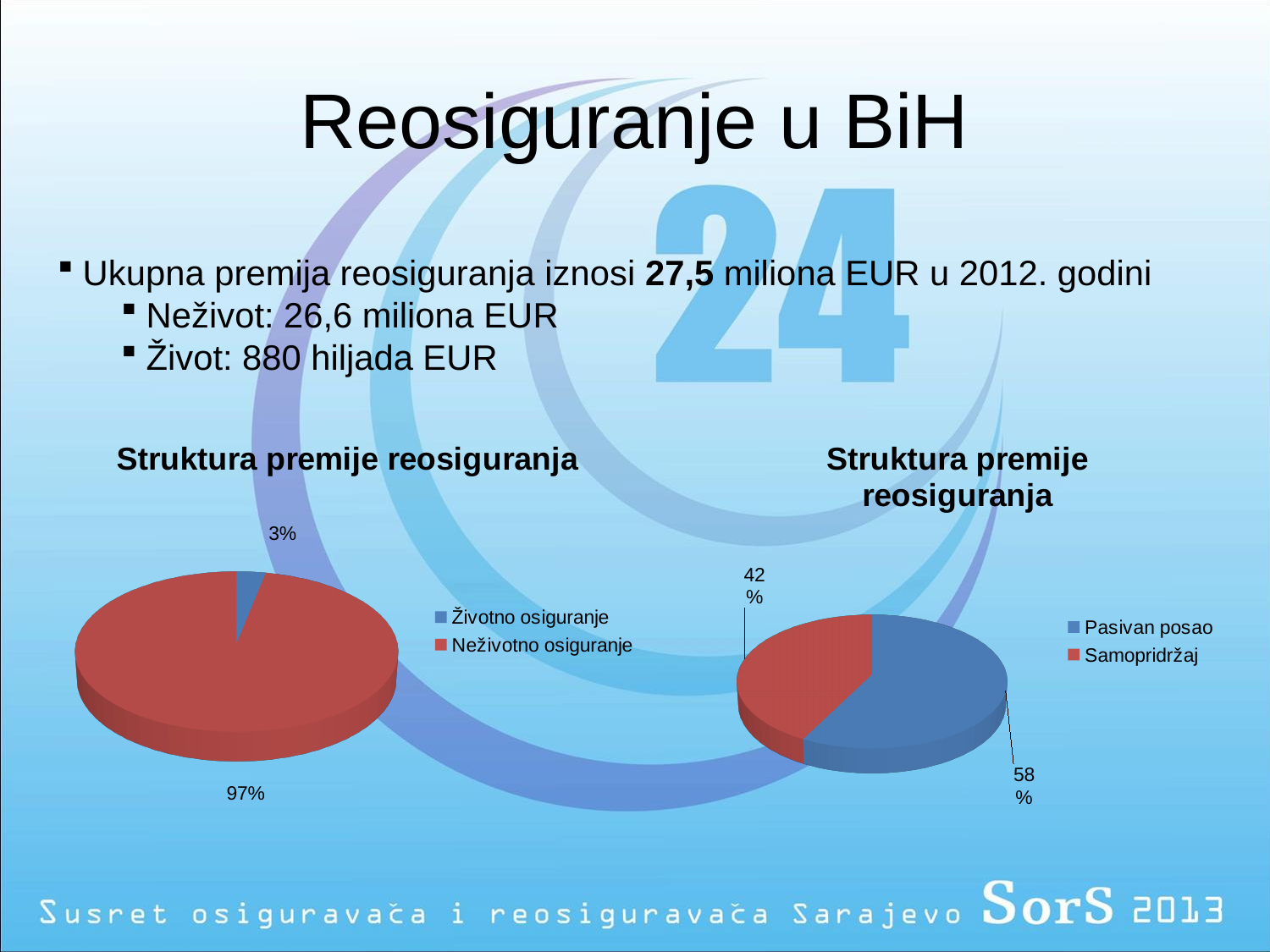
In the right pie chart, what is the difference in percentage points between Pasivan posao and Samopridržaj? 16 What is the title of the left pie chart? Struktura premije reosiguranja What type of chart is the left chart on the slide? Pie chart In the right pie chart, which category has the smallest slice? Samopridržaj How many categories does the legend of the right pie chart list? 2 In the right pie chart, what share does Pasivan posao have? 58% In the left pie chart, which category has the largest slice? Neživotno osiguranje In the right pie chart, what share does Samopridržaj have? 42% In the left pie chart, what is the difference in percentage points between Neživotno osiguranje and Životno osiguranje? 94 In the left pie chart, what share does Životno osiguranje have? 3% In the right pie chart, which is larger, Pasivan posao or Samopridržaj? Pasivan posao